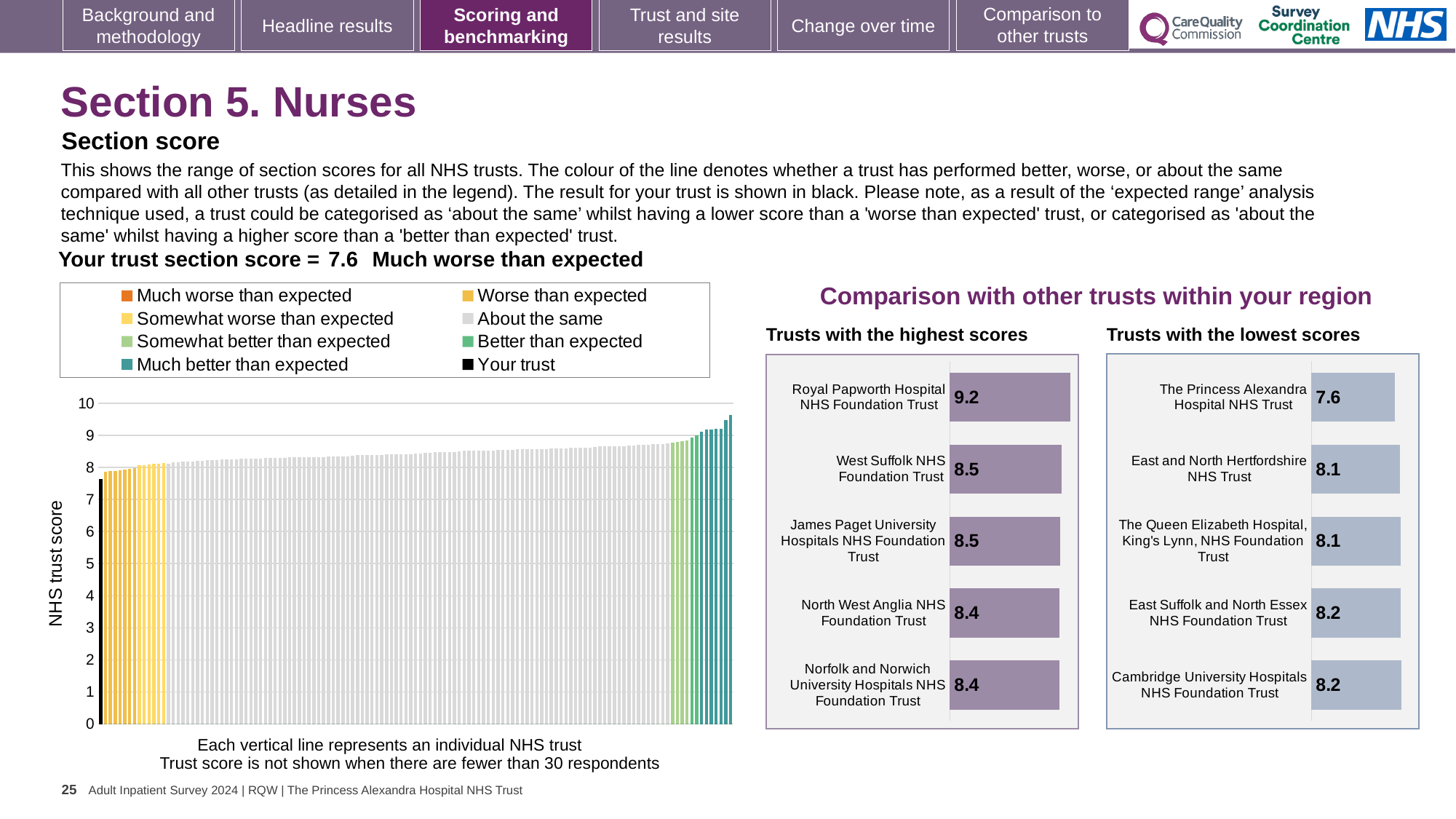
In the 'Trusts with the highest scores' chart, which has the higher score: James Paget University Hospitals NHS Foundation Trust or North West Anglia NHS Foundation Trust? James Paget University Hospitals NHS Foundation Trust In the main 'NHS trust score' chart on the left, is the value for the black 'Your trust' bar greater or less than 8? less In the 'Trusts with the highest scores' chart, what is the difference between the scores of Royal Papworth Hospital NHS Foundation Trust and West Suffolk NHS Foundation Trust? 0.7 How many entries does the legend of the main 'NHS trust score' chart on the left list? 8 What kind of chart is the main chart on the left showing NHS trust scores? Bar chart In the 'Trusts with the lowest scores' chart, which trust has the lowest score? The Princess Alexandra Hospital NHS Trust What is the y-axis label of the main chart on the left? NHS trust score In the 'Trusts with the highest scores' chart, which trust has the highest score? Royal Papworth Hospital NHS Foundation Trust In the 'Trusts with the highest scores' chart, what is the score for Royal Papworth Hospital NHS Foundation Trust? 9.2 How many trusts are listed in the 'Trusts with the highest scores' chart? 5 In the 'Trusts with the lowest scores' chart, what is the score for Cambridge University Hospitals NHS Foundation Trust? 8.2 In the main 'NHS trust score' chart on the left, do the bar heights rise or fall from left to right? Rise